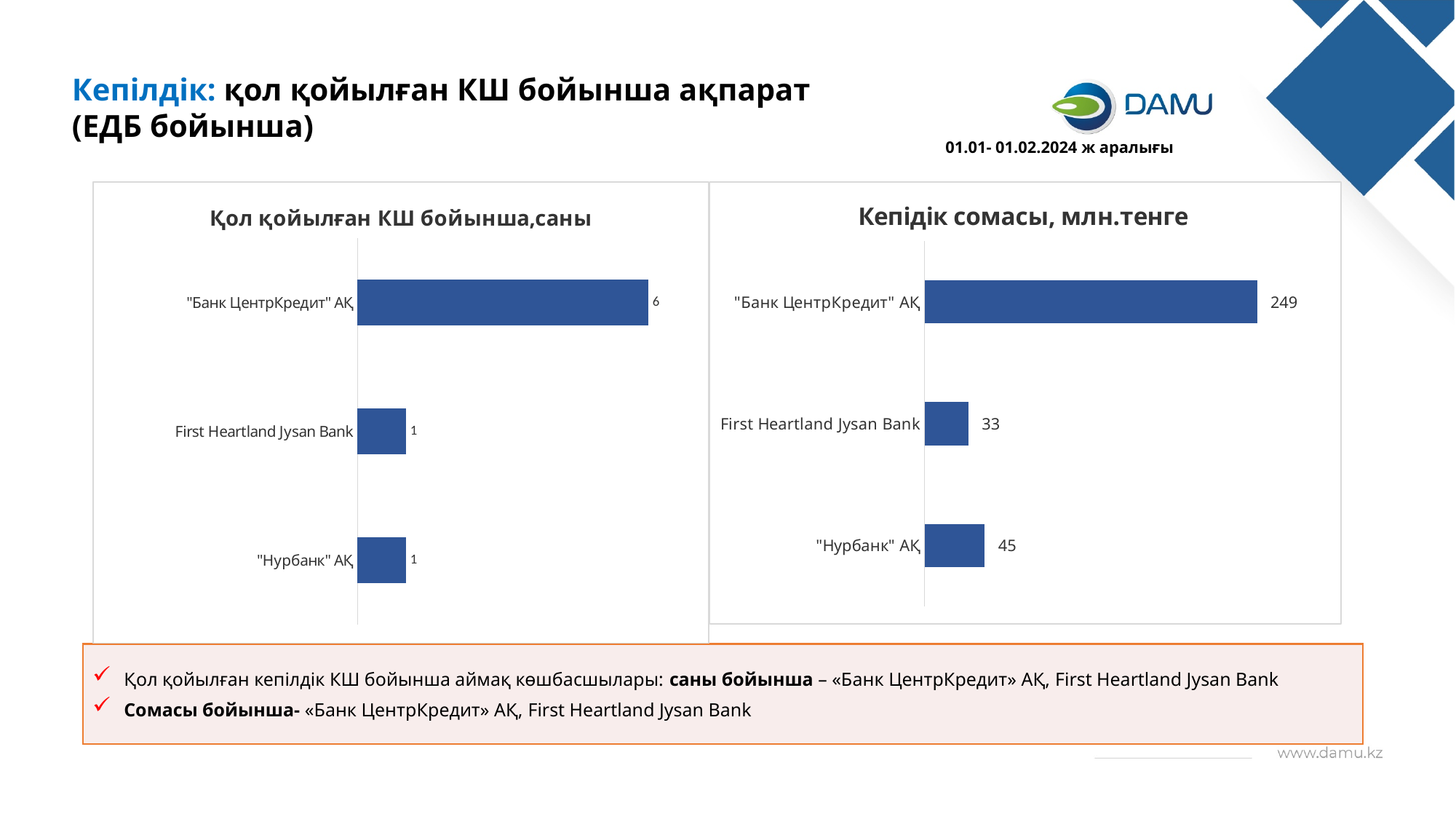
What is the title of the chart on the left side of the slide? Қол қойылған КШ бойынша,саны In the chart titled "Кепідік сомасы, млн.тенге", which bank has the highest value? "Банк ЦентрКредит" АҚ How many banks are shown in the chart titled "Қол қойылған КШ бойынша,саны"? 3 In the chart titled "Кепідік сомасы, млн.тенге", which is larger: "Нурбанк" АҚ or First Heartland Jysan Bank? "Нурбанк" АҚ In the chart titled "Кепідік сомасы, млн.тенге", which bank has the lowest value? First Heartland Jysan Bank In the chart titled "Қол қойылған КШ бойынша,саны", what is the difference between "Банк ЦентрКредит" АҚ and First Heartland Jysan Bank? 5 In the chart titled "Кепідік сомасы, млн.тенге", what is the value for "Нурбанк" АҚ? 45 In the chart titled "Кепідік сомасы, млн.тенге", what is the difference between "Банк ЦентрКредит" АҚ and "Нурбанк" АҚ? 204 In the chart titled "Кепідік сомасы, млн.тенге", what is the value for First Heartland Jysan Bank? 33 What kind of chart is the chart titled "Кепідік сомасы, млн.тенге"? Bar chart In the chart titled "Қол қойылған КШ бойынша,саны", which bank has the highest value? "Банк ЦентрКредит" АҚ In the chart titled "Қол қойылған КШ бойынша,саны", what is the value for "Банк ЦентрКредит" АҚ? 6